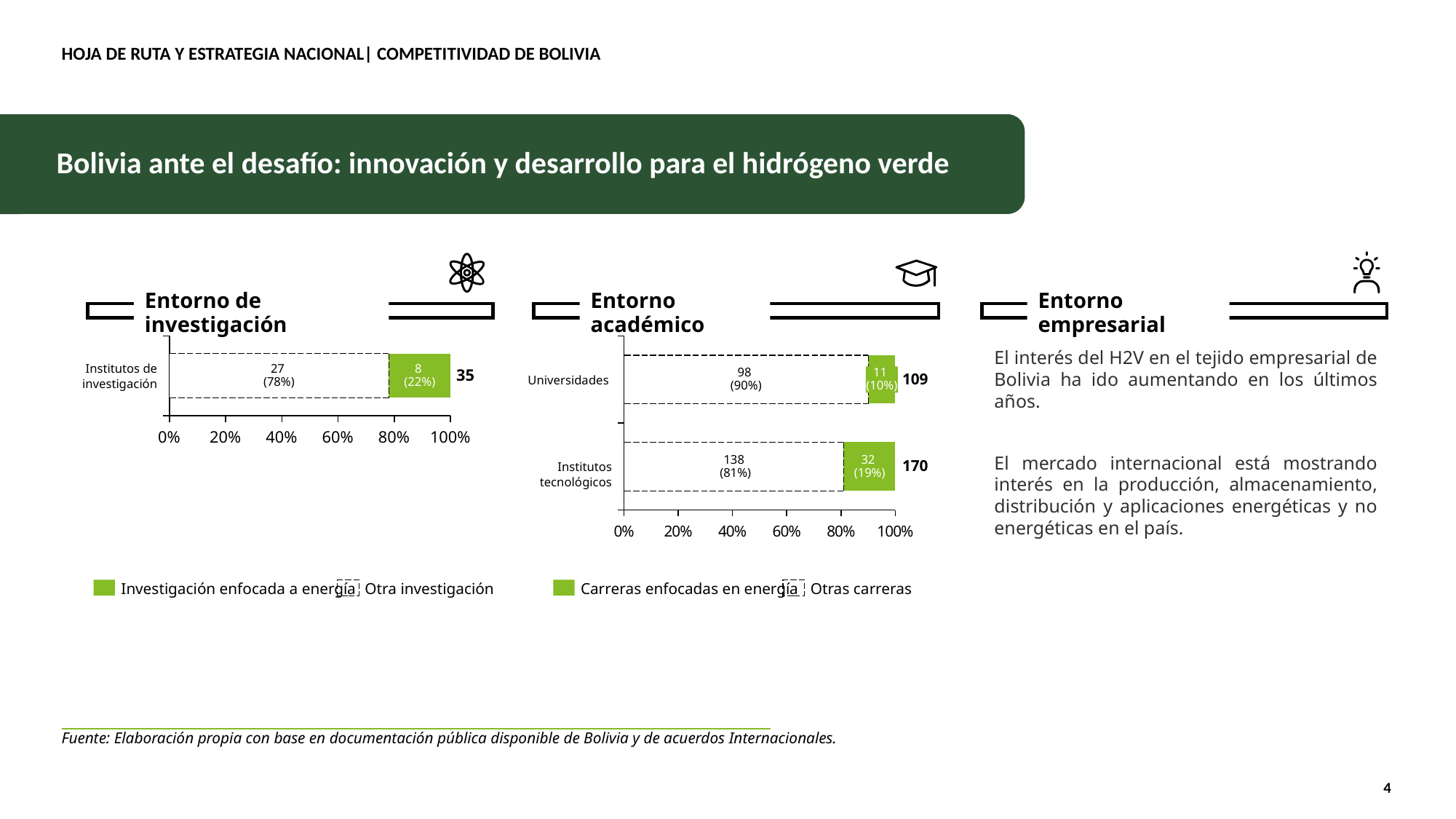
In the 'Entorno académico' chart, how many 'Carreras enfocadas en energía' are shown for Universidades? 11 In the 'Entorno de investigación' chart, how many research institutes are counted as 'Investigación enfocada a energía'? 8 In the 'Entorno de investigación' chart, what percentage of research institutes fall under 'Otra investigación'? 78% In the 'Entorno académico' chart, what is the difference between the 'Otras carreras' count for Institutos tecnológicos and for Universidades? 40 In the 'Entorno académico' chart, what is the total for Institutos tecnológicos? 170 How many series does the legend of the 'Entorno académico' chart list? 2 In the 'Entorno académico' chart, which category has the higher total, Universidades or Institutos tecnológicos? Institutos tecnológicos How many categories are plotted in the 'Entorno académico' chart? 2 What kind of chart is the 'Entorno de investigación' chart? Bar chart In the 'Entorno académico' chart, which category has the lowest share of 'Carreras enfocadas en energía'? Universidades In the 'Entorno de investigación' chart, what is the total number shown at the end of the 'Institutos de investigación' bar? 35 In the 'Entorno académico' chart, what percentage of Institutos tecnológicos careers are 'Otras carreras'? 81%